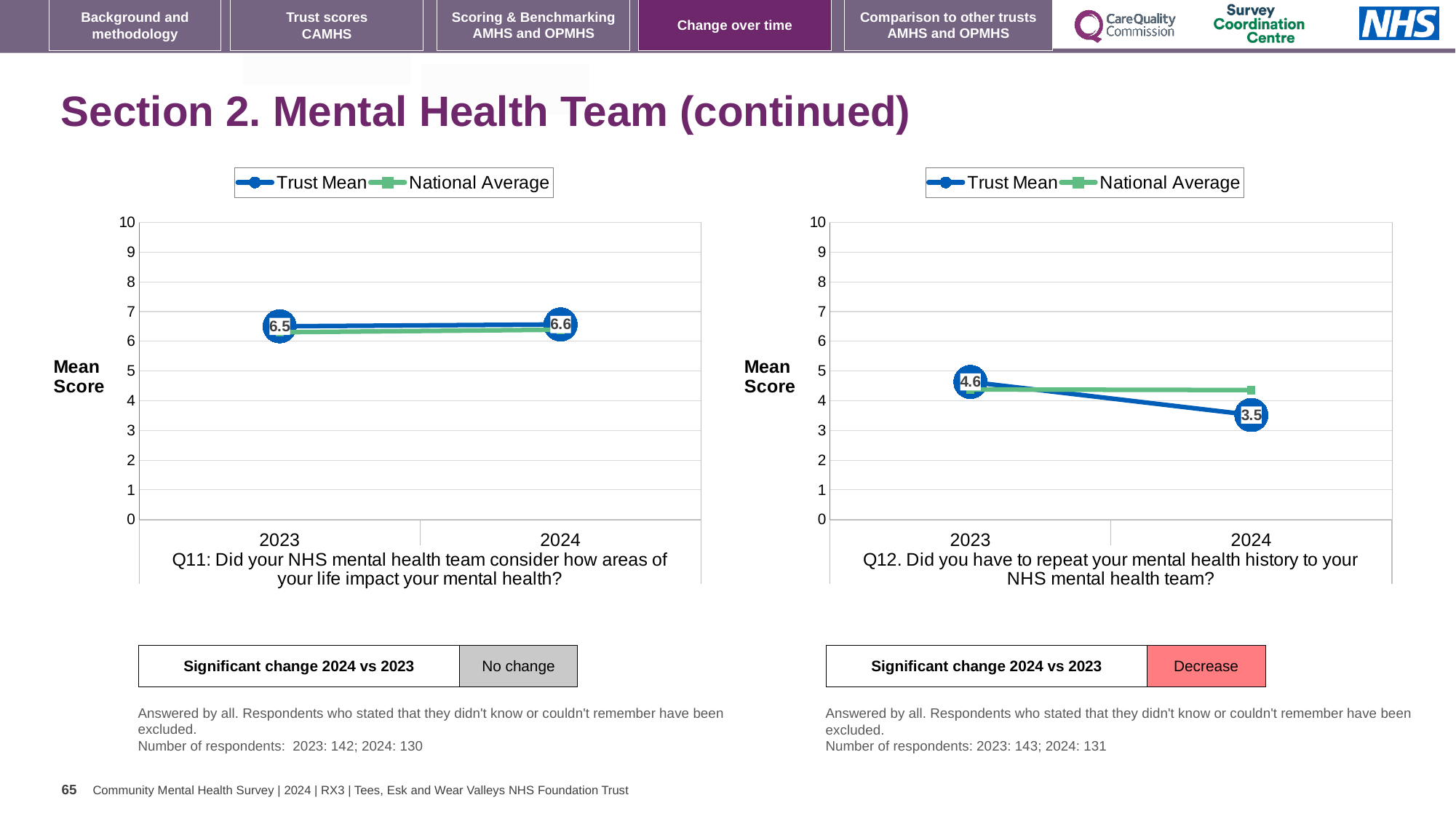
In the Q11 chart (left), what is the Trust Mean score for 2023? 6.5 In the Q12 chart (right), is the National Average value for 2024 greater or less than 4? greater In the Q12 chart (right), which is larger in 2024, the Trust Mean or the National Average? National Average In the Q12 chart (right), what is the Trust Mean score for 2024? 3.5 In the Q12 chart (right), by how much did the Trust Mean fall from 2023 to 2024? 1.1 In the Q11 chart (left), what is the Trust Mean score for 2024? 6.6 What kind of chart is the Q11 chart on the left? line chart How many series does the legend of the Q12 chart (right) list? 2 How many years are shown on the x axis of the Q11 chart (left)? 2 In the Q12 chart (right), does the Trust Mean rise or fall from 2023 to 2024? fall In the Q12 chart (right), what is the Trust Mean score for 2023? 4.6 In the Q11 chart (left), does the Trust Mean rise or fall from 2023 to 2024? rise